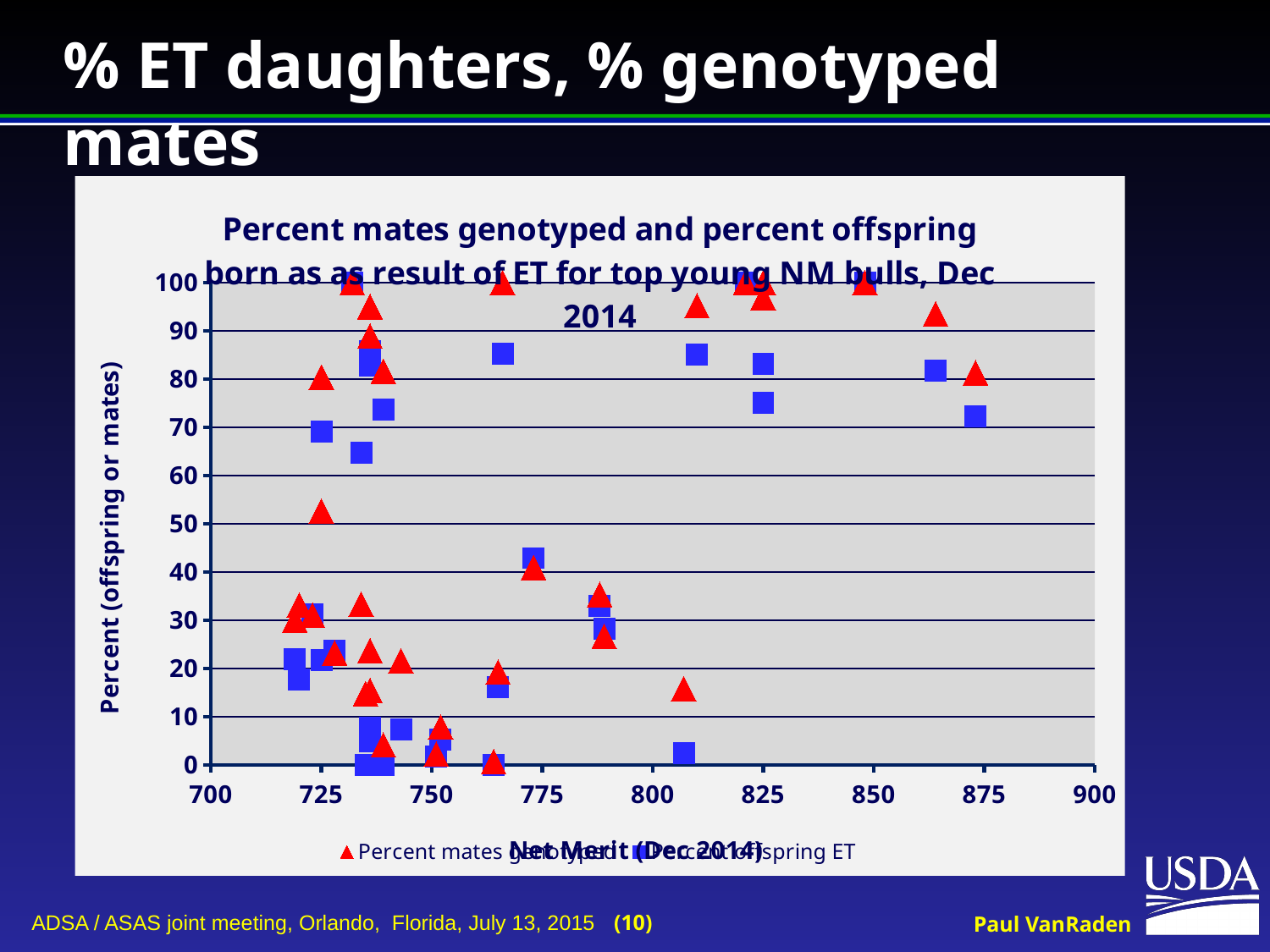
Is the lowest Net Merit value shown on the horizontal axis greater or less than 725? less How many series does the chart legend list? 2 What kind of chart is shown on the slide? scatter chart Is the highest value for the Percent mates genotyped series greater or less than 90? greater Which marker shape and colour represents the Percent mates genotyped series? red triangles What is the title of the vertical axis? Percent (offspring or mates) What is the highest value reached by the Percent mates genotyped series? 100 What is the lowest value reached by the Percent offspring ET series? 0